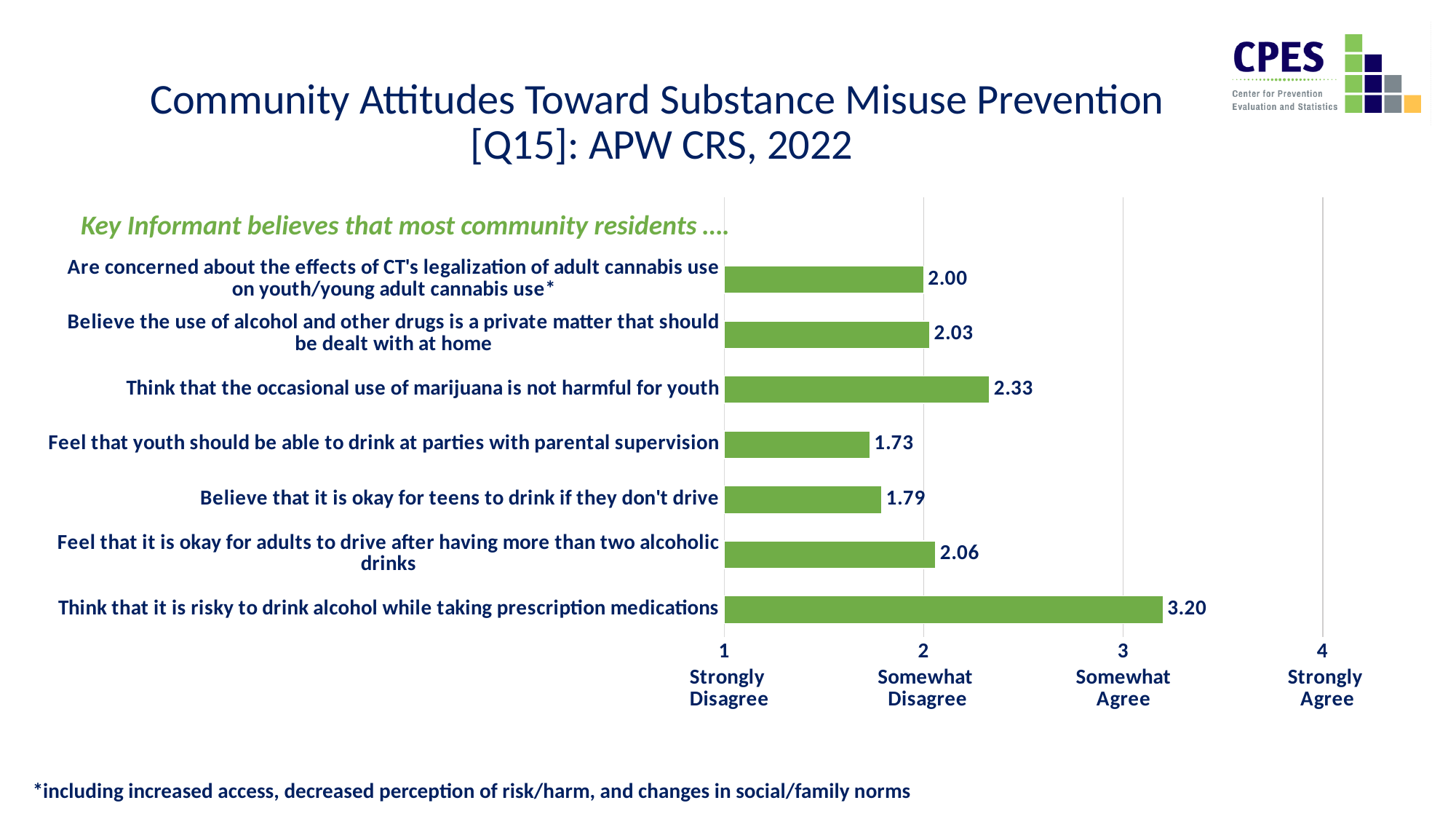
Which category has the highest value? Think that it is risky to drink alcohol while taking prescription medications How many categories are shown in the chart? 7 What label does the x axis show at the value 4? Strongly Agree What is the value for 'Believe that it is okay for teens to drink if they don't drive'? 1.79 Which is larger: the value for 'Feel that it is okay for adults to drive after having more than two alcoholic drinks' or the value for 'Believe the use of alcohol and other drugs is a private matter that should be dealt with at home'? Feel that it is okay for adults to drive after having more than two alcoholic drinks What is the value for 'Think that the occasional use of marijuana is not harmful for youth'? 2.33 What is the difference between the values for 'Think that it is risky to drink alcohol while taking prescription medications' and 'Think that the occasional use of marijuana is not harmful for youth'? 0.87 Which category has the lowest value? Feel that youth should be able to drink at parties with parental supervision What is the value for 'Think that it is risky to drink alcohol while taking prescription medications'? 3.20 What is the value for 'Feel that youth should be able to drink at parties with parental supervision'? 1.73 What kind of chart is shown on the slide? Bar chart Is the value for 'Think that it is risky to drink alcohol while taking prescription medications' greater or less than 3? greater